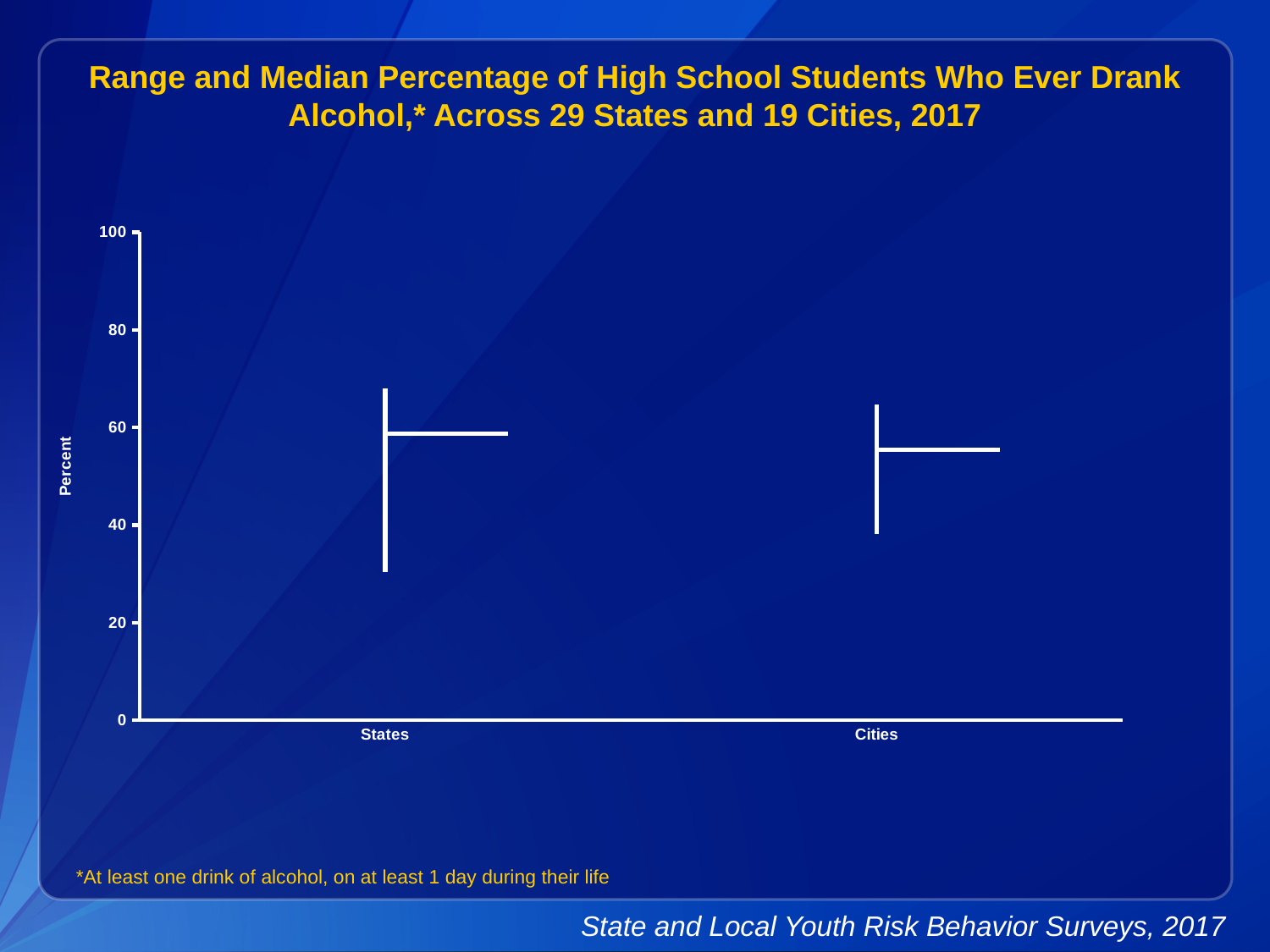
Is the highest value in the range for States greater or less than 60? greater Which category has the lower bottom of its range, States or Cities? States Is the highest value in the range for States greater or less than 80? less Is the median value for Cities greater or less than 60? less What is the label of the y axis? Percent Which category has the higher median value, States or Cities? States How many categories are shown on the x axis of the chart? 2 What are the two categories shown on the x axis? States and Cities